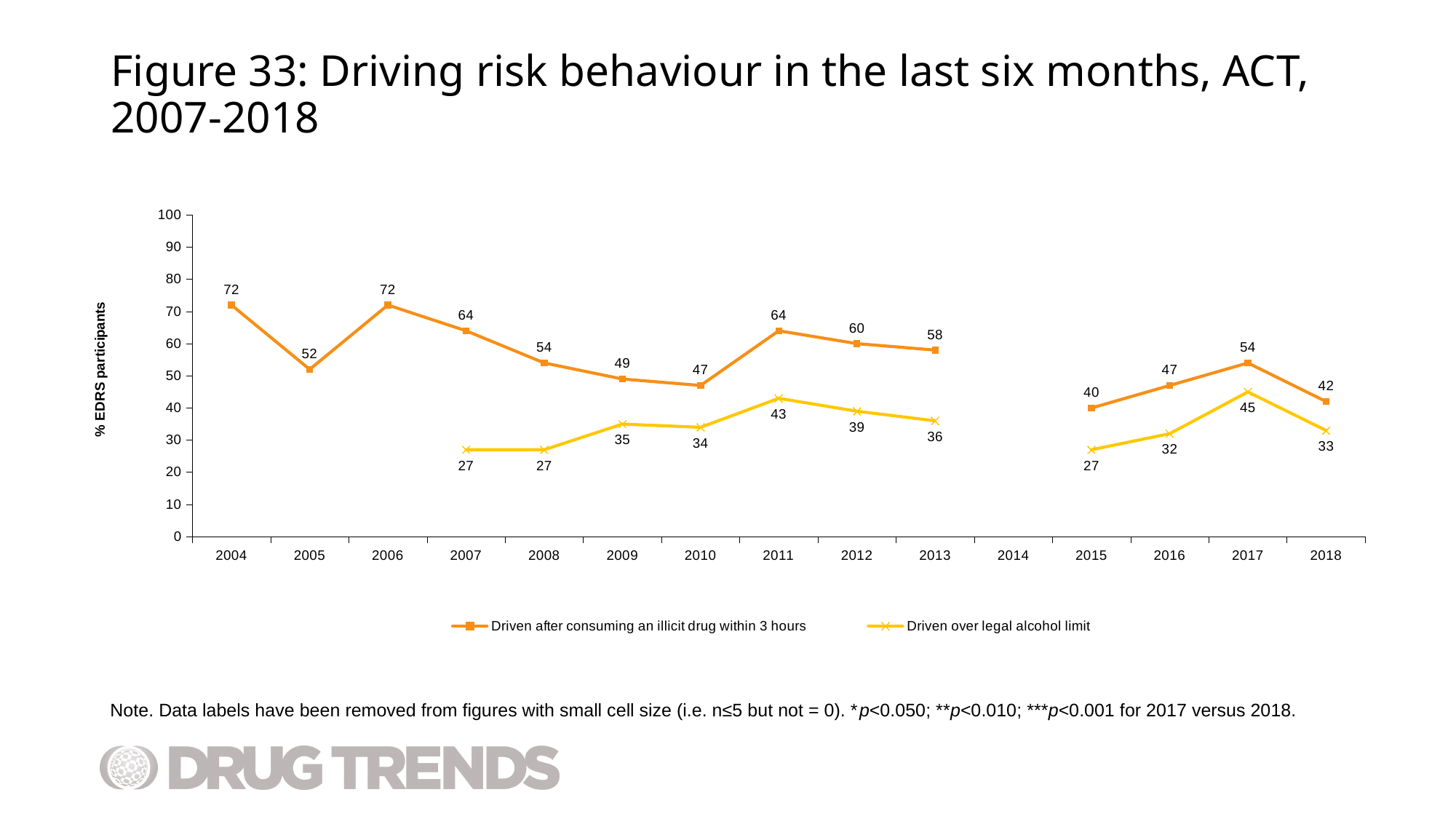
In 2013, which series has the higher value: 'Driven after consuming an illicit drug within 3 hours' or 'Driven over legal alcohol limit'? Driven after consuming an illicit drug within 3 hours Is the 2015 value for 'Driven after consuming an illicit drug within 3 hours' greater or less than 50? less What is the label on the y axis? % EDRS participants What percentage of EDRS participants reported having driven after consuming an illicit drug within 3 hours in 2011? 64 In which year(s) did the 'Driven after consuming an illicit drug within 3 hours' series reach its highest value? 2004 and 2006 What is the lowest value shown for the 'Driven over legal alcohol limit' series? 27 Did the 'Driven over legal alcohol limit' series rise or fall from 2015 to 2017? Rise What kind of chart is shown on the slide? Line chart What is the difference between the 2017 and 2018 values for 'Driven after consuming an illicit drug within 3 hours'? 12 What percentage of EDRS participants reported having driven over the legal alcohol limit in 2017? 45 How many series does the legend list? 2 Which year on the x axis has no data plotted for either series? 2014